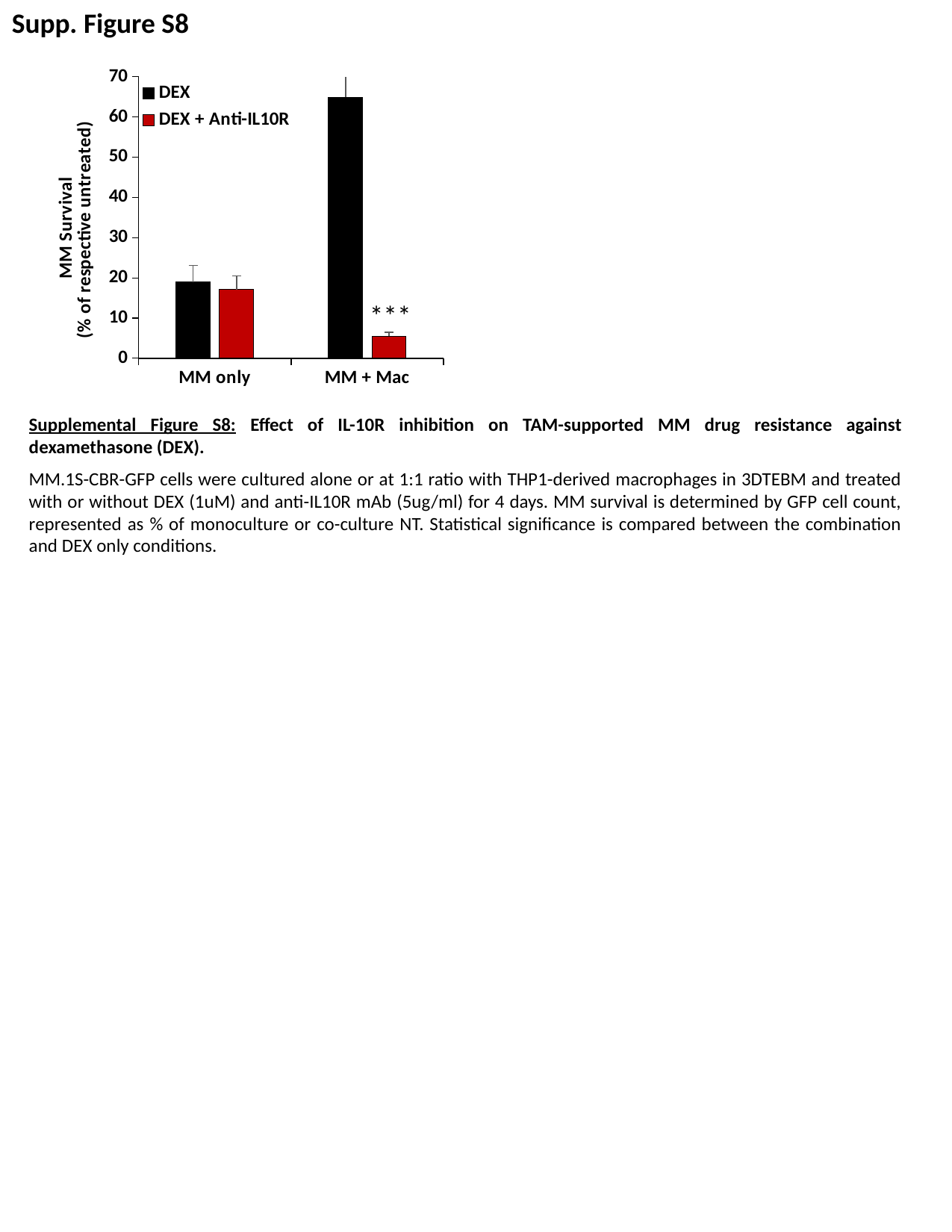
How many series does the chart's legend list? 2 Which series and category has the lowest bar in the chart? DEX + Anti-IL10R for MM + Mac Is the DEX + Anti-IL10R value for MM + Mac greater or less than 10? less What kind of chart is shown on the slide? bar chart Which series and category has the highest bar in the chart? DEX for MM + Mac Is the DEX value for MM + Mac greater or less than 60? greater How many categories are shown on the x axis of the chart? 2 For MM + Mac, which is larger: the DEX bar or the DEX + Anti-IL10R bar? DEX Is the DEX value for MM only greater or less than 30? less Which colour represents the DEX + Anti-IL10R series in the chart? red What is the label of the y axis of the chart? MM Survival (% of respective untreated)